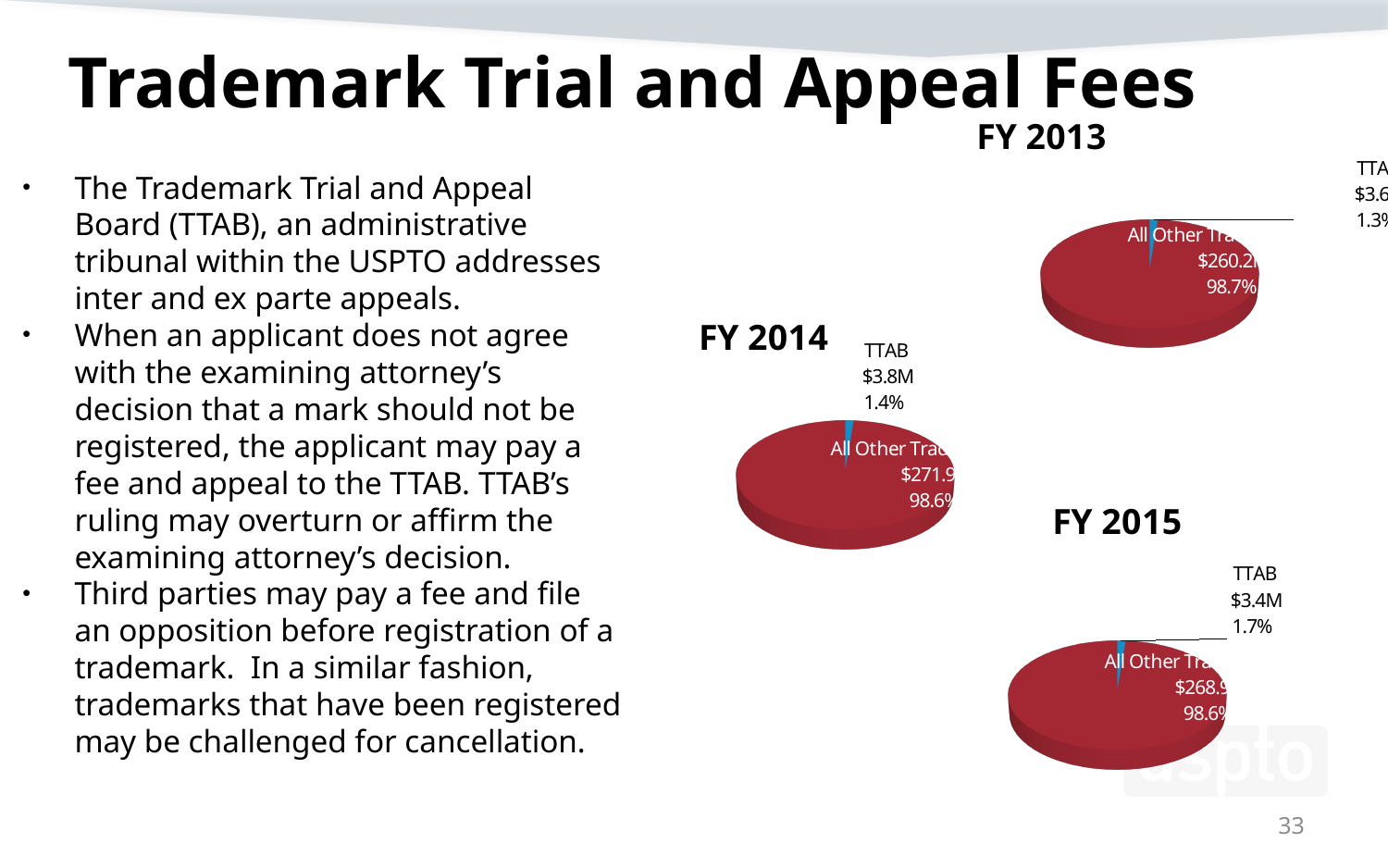
In the FY 2013 pie chart, what percentage share does the All Other Trademark slice have? 98.7% In the FY 2014 pie chart, what percentage share does TTAB have? 1.4% In the FY 2014 pie chart, what is the value shown for TTAB? $3.8M In the FY 2015 pie chart, what colour is the TTAB slice? Blue How many slices does the FY 2015 pie chart have? 2 In the FY 2014 pie chart, which slice is larger, TTAB or All Other Trademark? All Other Trademark In the FY 2015 pie chart, what is the value shown for TTAB? $3.4M Comparing the TTAB values in the FY 2014 and FY 2015 pie charts, which year is higher? FY 2014 In the FY 2015 pie chart, what percentage share does TTAB have? 1.7% How many pie charts are shown on the slide? 3 What is the difference between the TTAB value in the FY 2014 pie chart and the TTAB value in the FY 2015 pie chart? $0.4M What kind of chart is used for FY 2014? Pie chart